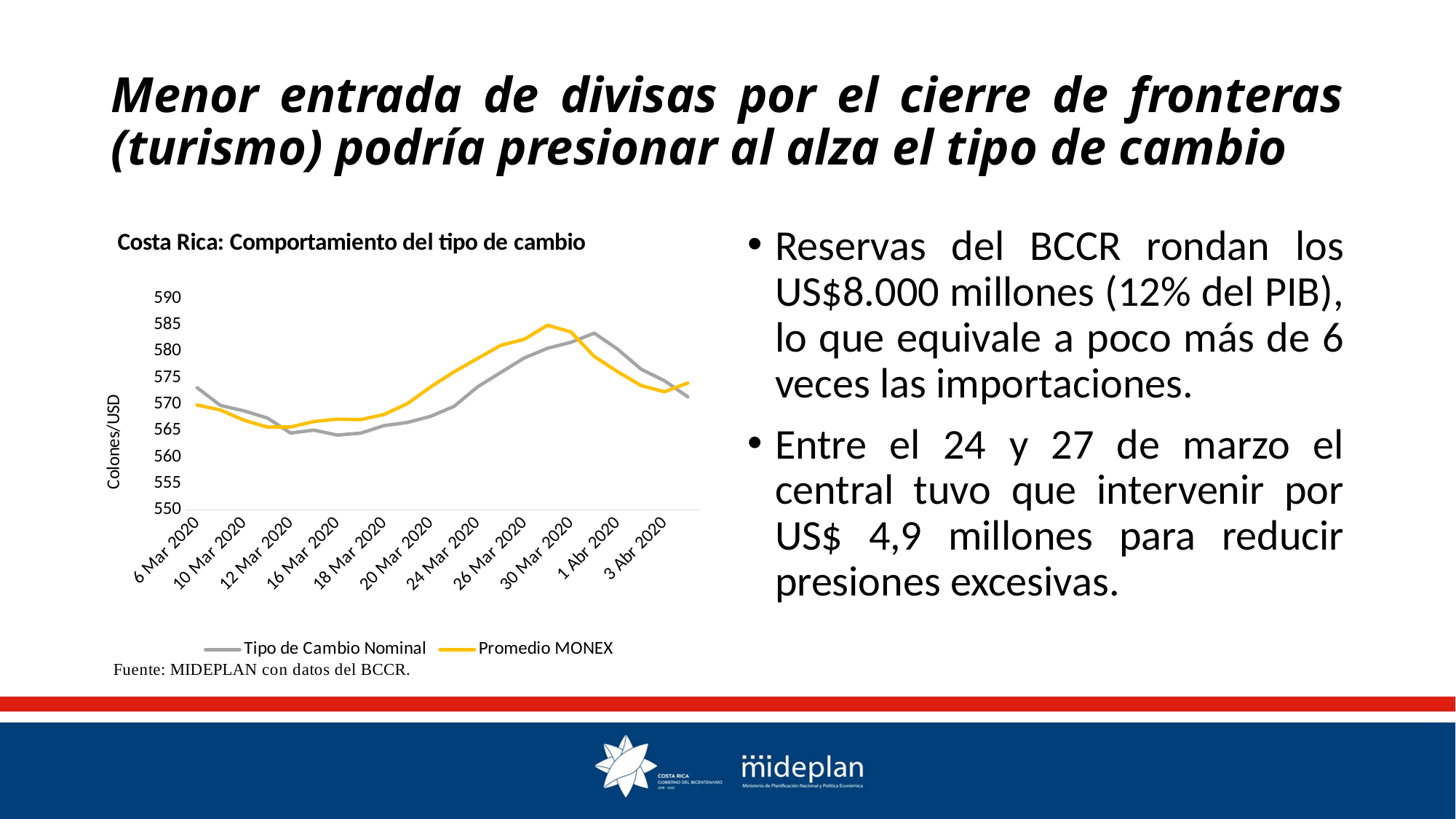
What is the title of the chart? Costa Rica: Comportamiento del tipo de cambio Around which date does the Tipo de Cambio Nominal series reach its lowest value? 16 Mar 2020 Is the value of Tipo de Cambio Nominal at 16 Mar 2020 greater or less than 570? less Is the value of Tipo de Cambio Nominal at 1 Abr 2020 greater or less than 575? greater How many date labels are shown on the x axis of the chart? 11 Is the value of Promedio MONEX at 30 Mar 2020 greater or less than 580? greater What is the label of the vertical axis of the chart? Colones/USD How many series does the chart legend list? 2 At 24 Mar 2020, which series has the higher value, Tipo de Cambio Nominal or Promedio MONEX? Promedio MONEX Does the Promedio MONEX series rise or fall between 16 Mar 2020 and 30 Mar 2020? Rise What kind of chart is shown on the slide? Line chart